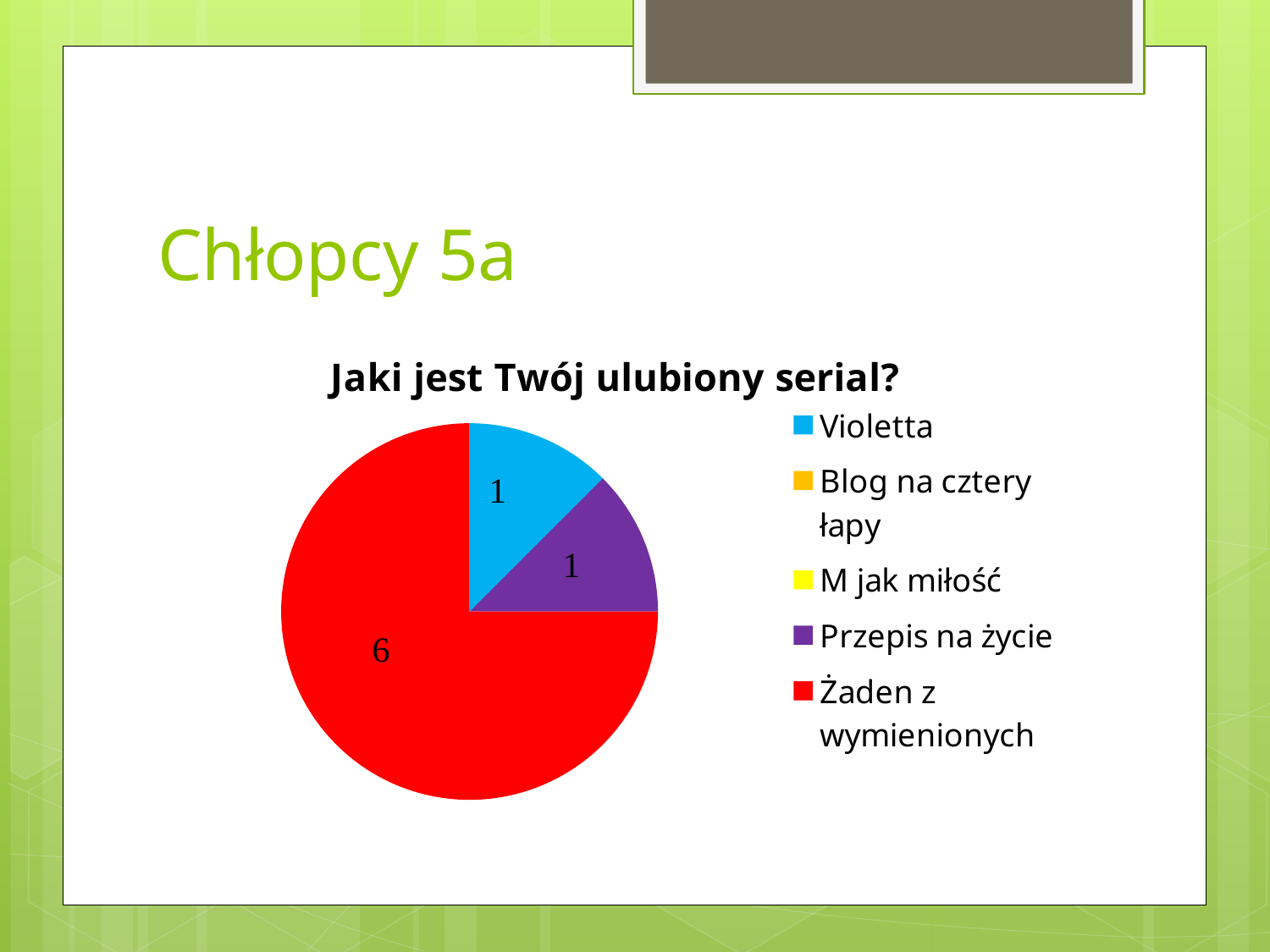
Which is larger, the value for Żaden z wymienionych or the value for Violetta? Żaden z wymienionych What is the value for Violetta? 1 What is the value for Przepis na życie? 1 What type of chart is shown on the slide? pie chart How many entries does the legend list? 5 What is the title of the chart? Jaki jest Twój ulubiony serial? What colour is the slice for Żaden z wymienionych? red What is the value for Żaden z wymienionych? 6 What is the difference between the value for Żaden z wymienionych and the value for Przepis na życie? 5 How many slices with data labels are visible in the pie? 3 Which category has the largest slice of the pie? Żaden z wymienionych